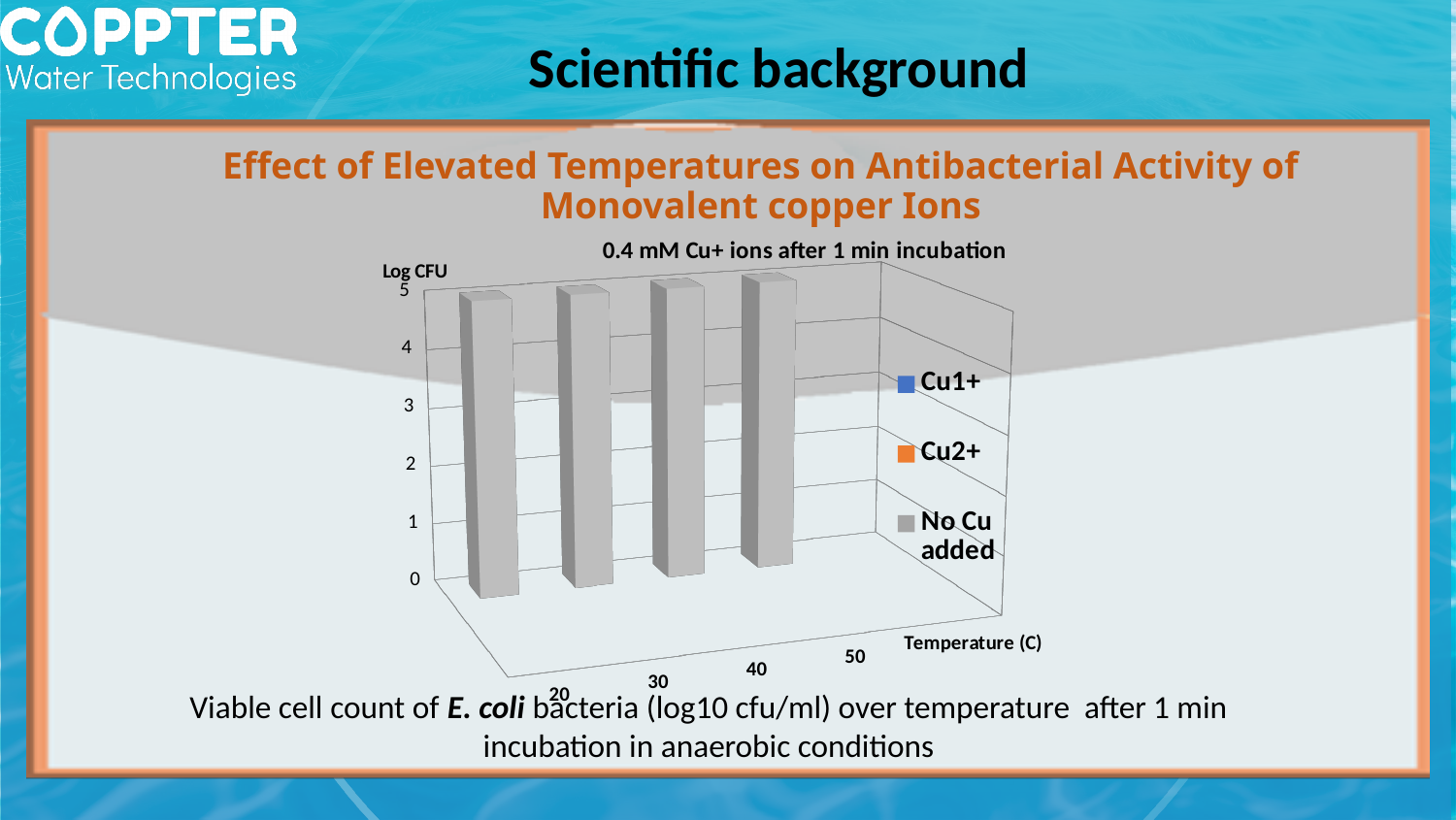
How many temperature categories are shown on the x axis of the chart? 4 What is the title of the chart? 0.4 mM Cu+ ions after 1 min incubation What is the label of the vertical axis of the chart? Log CFU Is the value for No Cu added at 40 C greater or less than 4? greater What are the three series listed in the chart's legend? Cu1+, Cu2+, No Cu added Is the value for No Cu added at 30 C greater or less than 2? greater Is the value for No Cu added at 20 C greater or less than 4? greater How many series does the chart's legend list? 3 What kind of chart is shown on the slide? bar chart